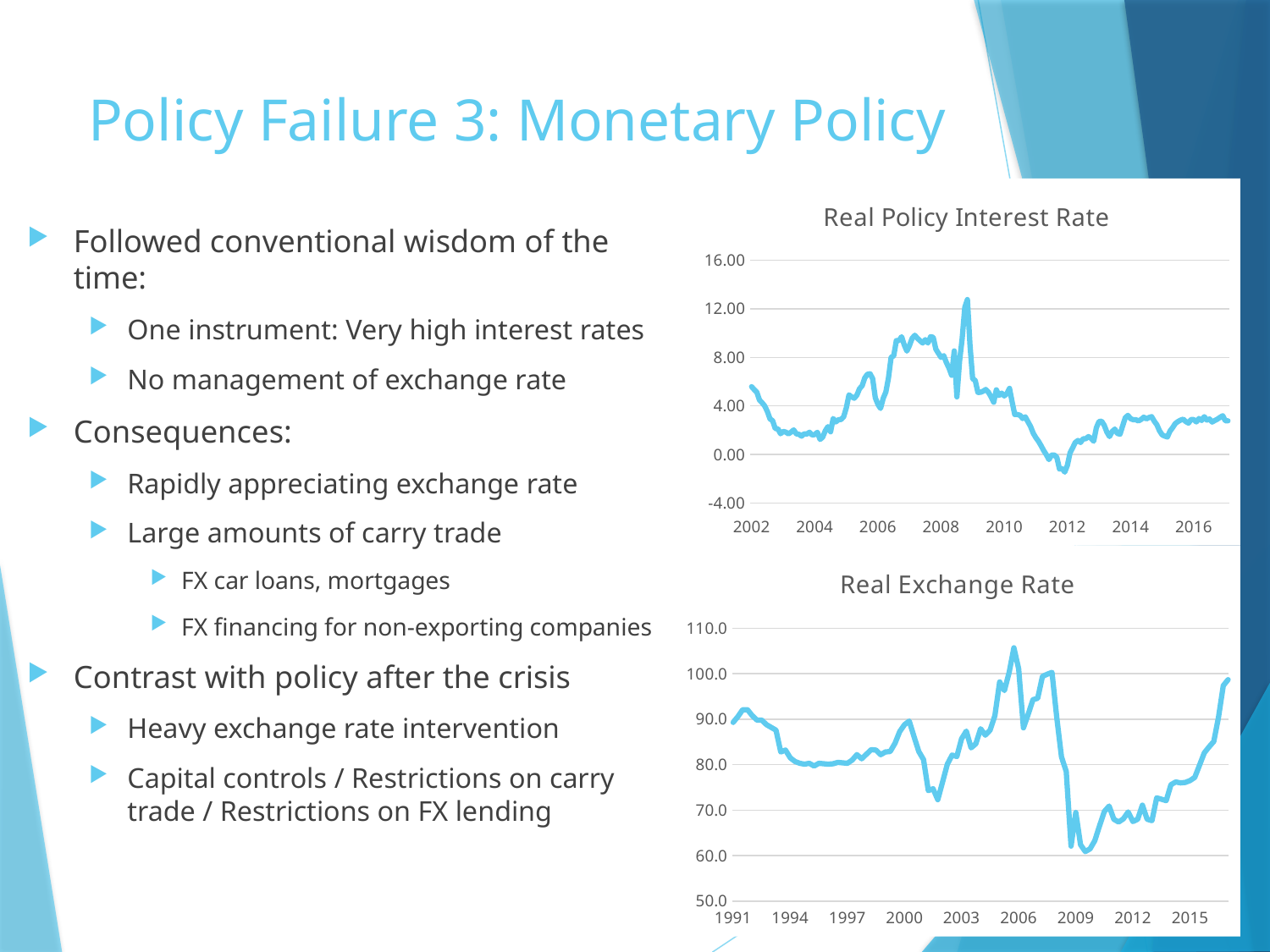
In the Real Exchange Rate chart, is the peak value around 2006 greater or less than 100.0? greater In the Real Policy Interest Rate chart, is the value around 2004 greater or less than 4.00? less In the Real Policy Interest Rate chart, is the peak value around 2009 greater or less than 8.00? greater In the Real Exchange Rate chart, does the value rise or fall between 2012 and 2015? rise In the Real Policy Interest Rate chart, does the value rise or fall between 2009 and 2012? fall What is the title of the lower chart on the slide? Real Exchange Rate What kind of chart is the Real Exchange Rate chart? line chart What kind of chart is the Real Policy Interest Rate chart? line chart What is the title of the upper chart on the slide? Real Policy Interest Rate